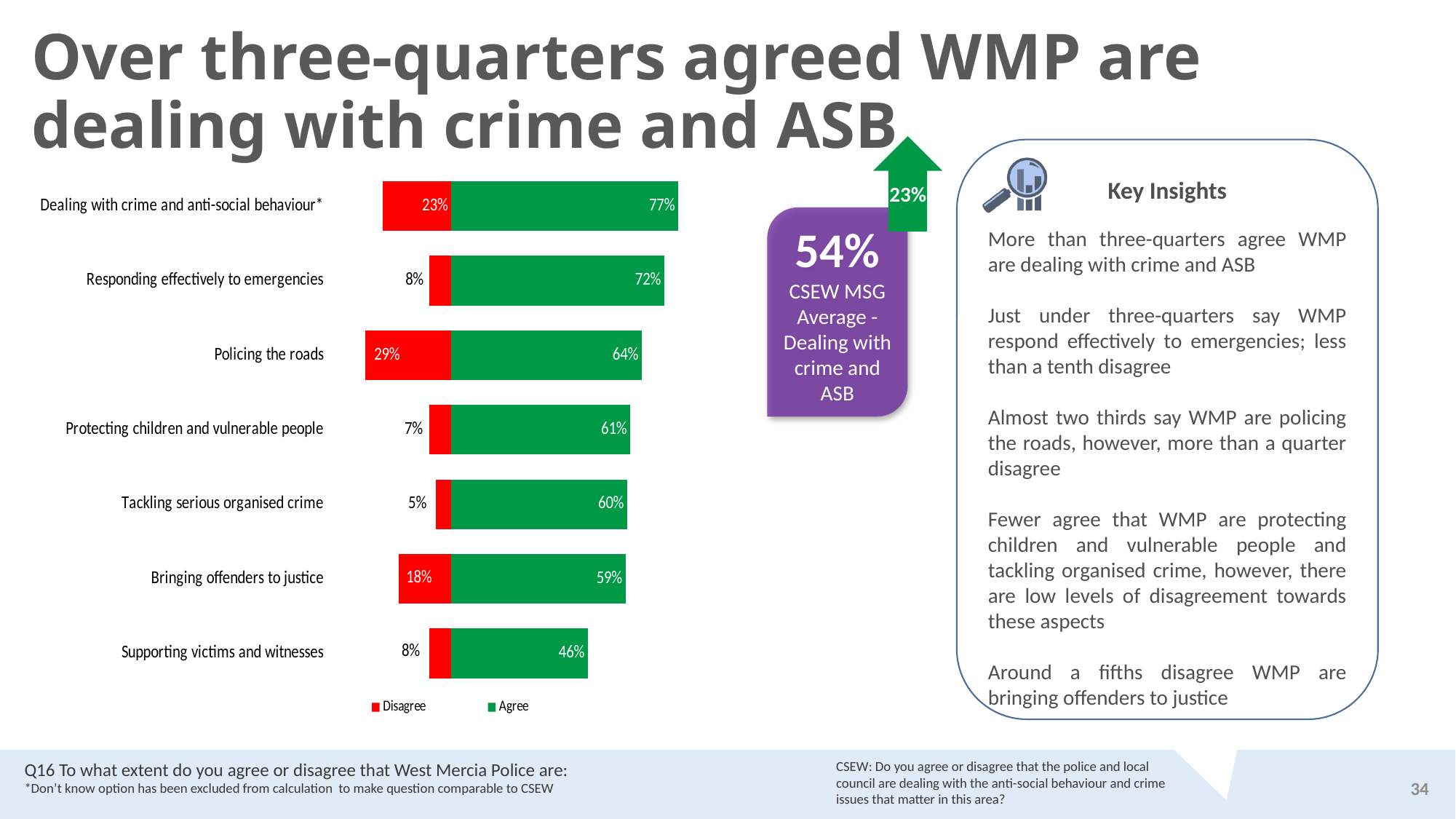
What is the Agree value for Supporting victims and witnesses? 46% How many series does the legend list? 2 Which category has the lowest Disagree percentage? Tackling serious organised crime Which has a higher Agree percentage: Responding effectively to emergencies or Protecting children and vulnerable people? Responding effectively to emergencies What percentage disagree that WMP are policing the roads? 29% What type of chart is shown on the slide? Bar chart How many categories are shown in the chart? 7 What is the difference between the Agree and Disagree percentages for Policing the roads? 35% Which category has the lowest Agree percentage? Supporting victims and witnesses What percentage agree that WMP are dealing with crime and anti-social behaviour? 77% Which category has the highest Agree percentage? Dealing with crime and anti-social behaviour What is the Disagree value for Bringing offenders to justice? 18%